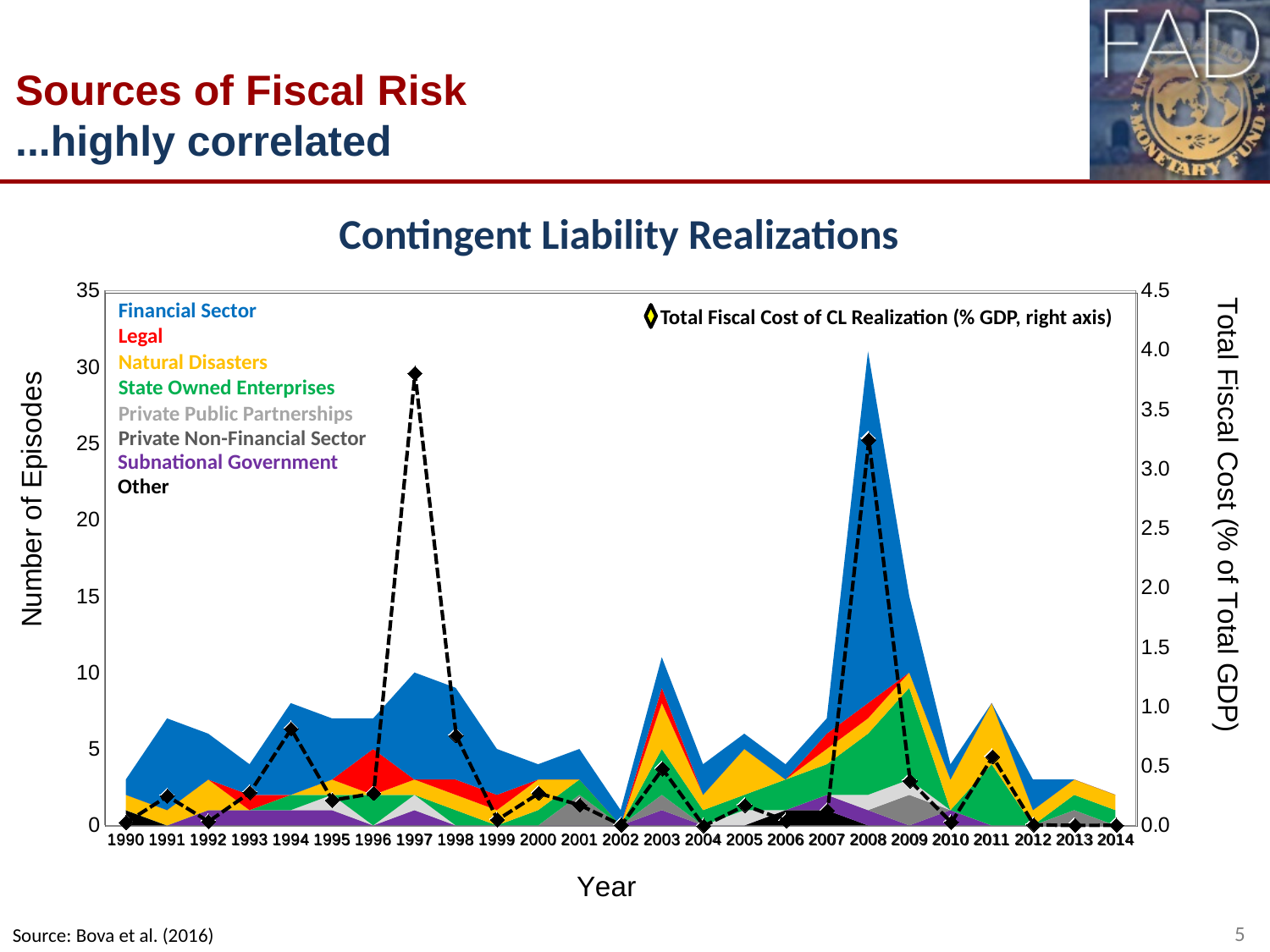
What is the label of the right-hand vertical axis? Total Fiscal Cost (% of Total GDP) How many years are plotted along the x axis? 25 How many series does the legend list in total, including the line series? 9 Which year has the larger Total Fiscal Cost of CL Realization, 1997 or 2008? 1997 Is the total number of episodes in 1997 greater or less than 5? greater What is the title of the chart? Contingent Liability Realizations Is the Total Fiscal Cost of CL Realization in 1997 greater or less than 3.5? greater In which year is the Total Fiscal Cost of CL Realization (% GDP) highest? 1997 What kind of chart is shown on the slide? Stacked area chart with a line Is the total number of episodes in 2008 greater or less than 25? greater In which year is the total number of episodes highest? 2008